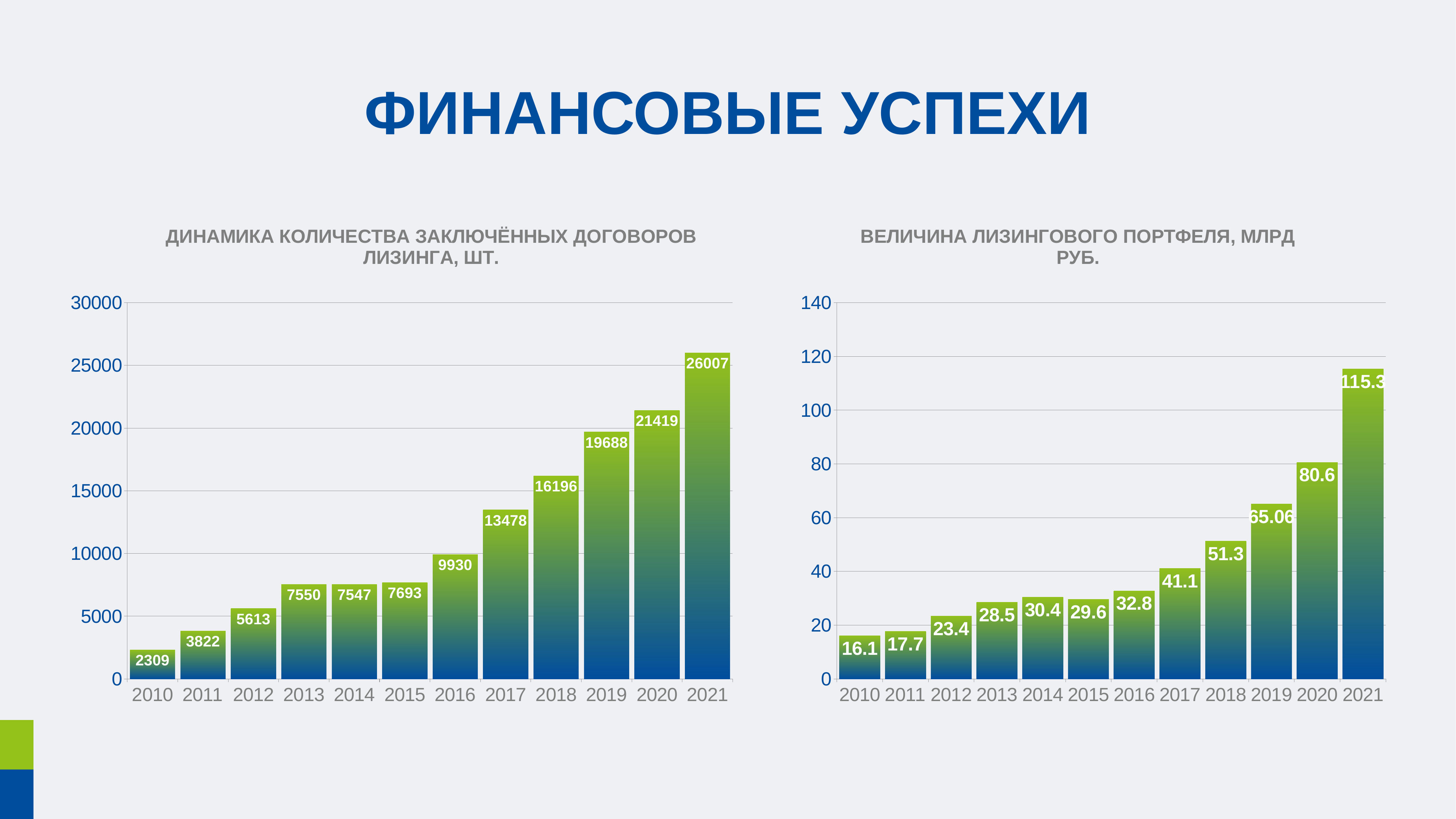
In the right chart (ВЕЛИЧИНА ЛИЗИНГОВОГО ПОРТФЕЛЯ, МЛРД РУБ.), is the value for 2021 greater or less than 100? greater In the right chart (ВЕЛИЧИНА ЛИЗИНГОВОГО ПОРТФЕЛЯ, МЛРД РУБ.), what is the value for 2010? 16.1 What kind of chart is the left chart (ДИНАМИКА КОЛИЧЕСТВА ЗАКЛЮЧЁННЫХ ДОГОВОРОВ ЛИЗИНГА, ШТ.)? Bar chart In the right chart (ВЕЛИЧИНА ЛИЗИНГОВОГО ПОРТФЕЛЯ, МЛРД РУБ.), what is the difference between the values for 2021 and 2020? 34.7 In the right chart (ВЕЛИЧИНА ЛИЗИНГОВОГО ПОРТФЕЛЯ, МЛРД РУБ.), which is larger, the value for 2014 or the value for 2015? 2014 In the right chart (ВЕЛИЧИНА ЛИЗИНГОВОГО ПОРТФЕЛЯ, МЛРД РУБ.), what is the value for 2019? 65.06 In the left chart (ДИНАМИКА КОЛИЧЕСТВА ЗАКЛЮЧЁННЫХ ДОГОВОРОВ ЛИЗИНГА, ШТ.), what is the difference between the values for 2021 and 2020? 4588 In the left chart (ДИНАМИКА КОЛИЧЕСТВА ЗАКЛЮЧЁННЫХ ДОГОВОРОВ ЛИЗИНГА, ШТ.), how many years are shown on the x axis? 12 In the left chart (ДИНАМИКА КОЛИЧЕСТВА ЗАКЛЮЧЁННЫХ ДОГОВОРОВ ЛИЗИНГА, ШТ.), which year has the highest value? 2021 In the right chart (ВЕЛИЧИНА ЛИЗИНГОВОГО ПОРТФЕЛЯ, МЛРД РУБ.), do the values generally rise or fall from 2010 to 2021? Rise In the left chart (ДИНАМИКА КОЛИЧЕСТВА ЗАКЛЮЧЁННЫХ ДОГОВОРОВ ЛИЗИНГА, ШТ.), what is the value for 2016? 9930 In the left chart (ДИНАМИКА КОЛИЧЕСТВА ЗАКЛЮЧЁННЫХ ДОГОВОРОВ ЛИЗИНГА, ШТ.), which year has the lowest value? 2010